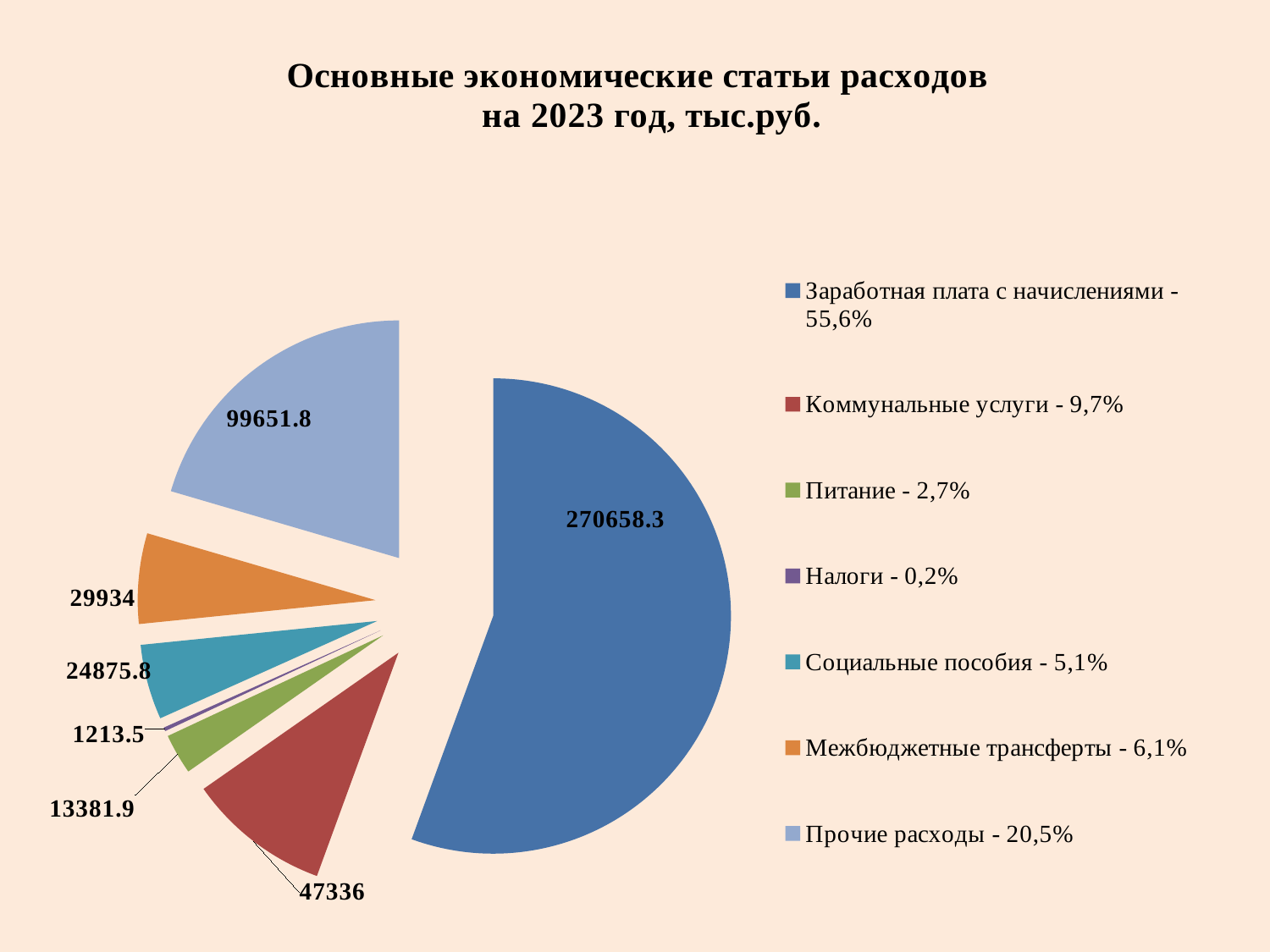
What share of the pie does Прочие расходы represent? 20,5% How many categories does the pie chart have? 7 What share of the pie does Социальные пособия represent? 5,1% Which category has the smallest slice of the pie? Налоги What type of chart is shown on the slide? pie chart What is the value for Прочие расходы? 99651.8 Which category has the largest slice of the pie? Заработная плата с начислениями What is the value for Заработная плата с начислениями? 270658.3 What is the value for Налоги? 1213.5 What is the value for Коммунальные услуги? 47336 Which is larger, the value for Межбюджетные трансферты or the value for Социальные пособия? Межбюджетные трансферты What is the difference between the values for Заработная плата с начислениями and Прочие расходы? 171006.5